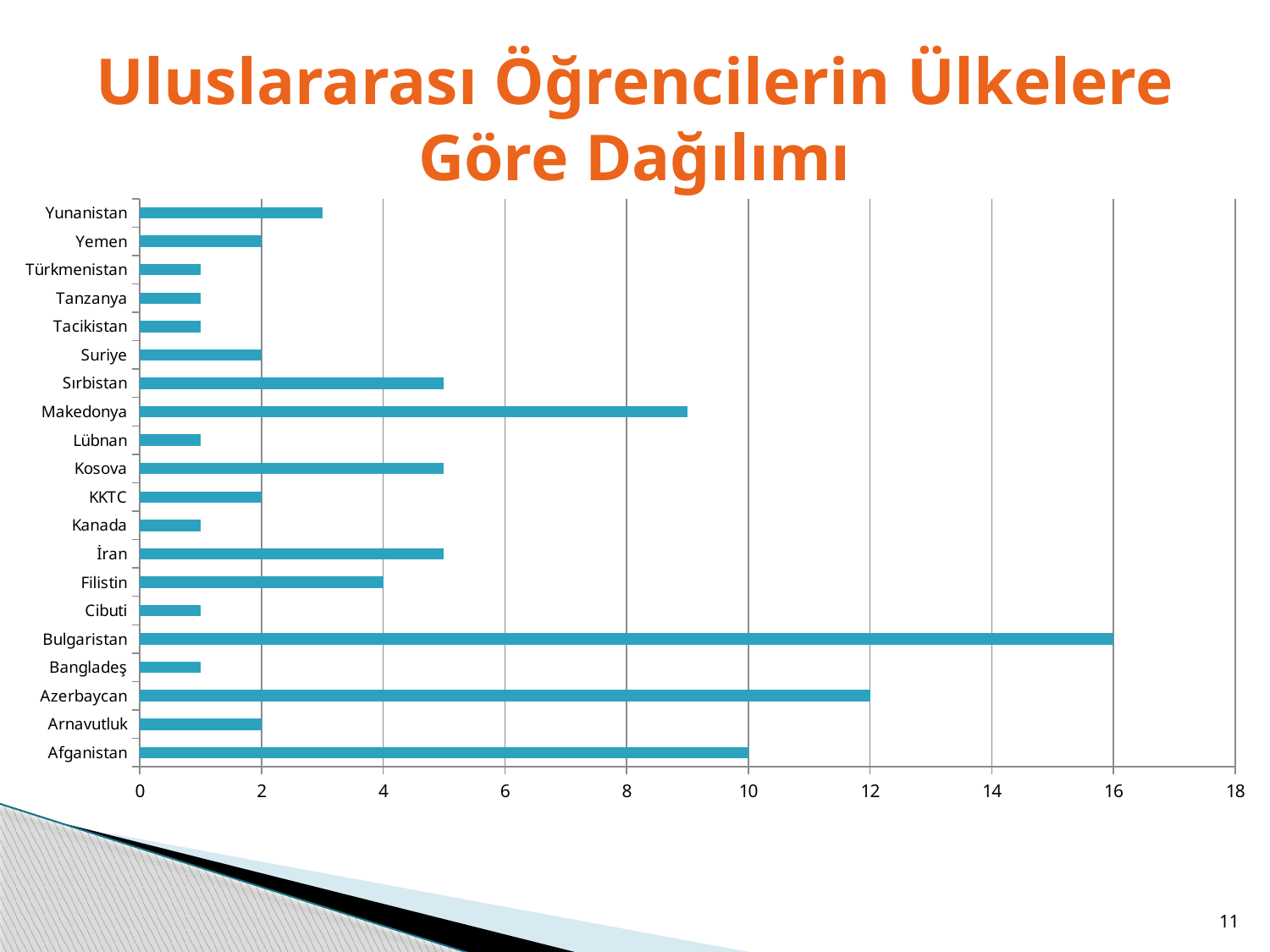
What is the value for Bulgaristan? 16 Which is larger, the value for Azerbaycan or the value for Afganistan? Azerbaycan Is the value for Türkmenistan greater or less than 2? less What is the value for Azerbaycan? 12 What is the difference between the values for Bulgaristan and Azerbaycan? 4 What is the value for Filistin? 4 How many countries are listed on the chart? 20 Is the value for Makedonya greater or less than 8? greater What is the title of the chart? Uluslararası Öğrencilerin Ülkelere Göre Dağılımı What type of chart is shown on the slide? bar chart What is the value for Afganistan? 10 Which country has the highest value? Bulgaristan